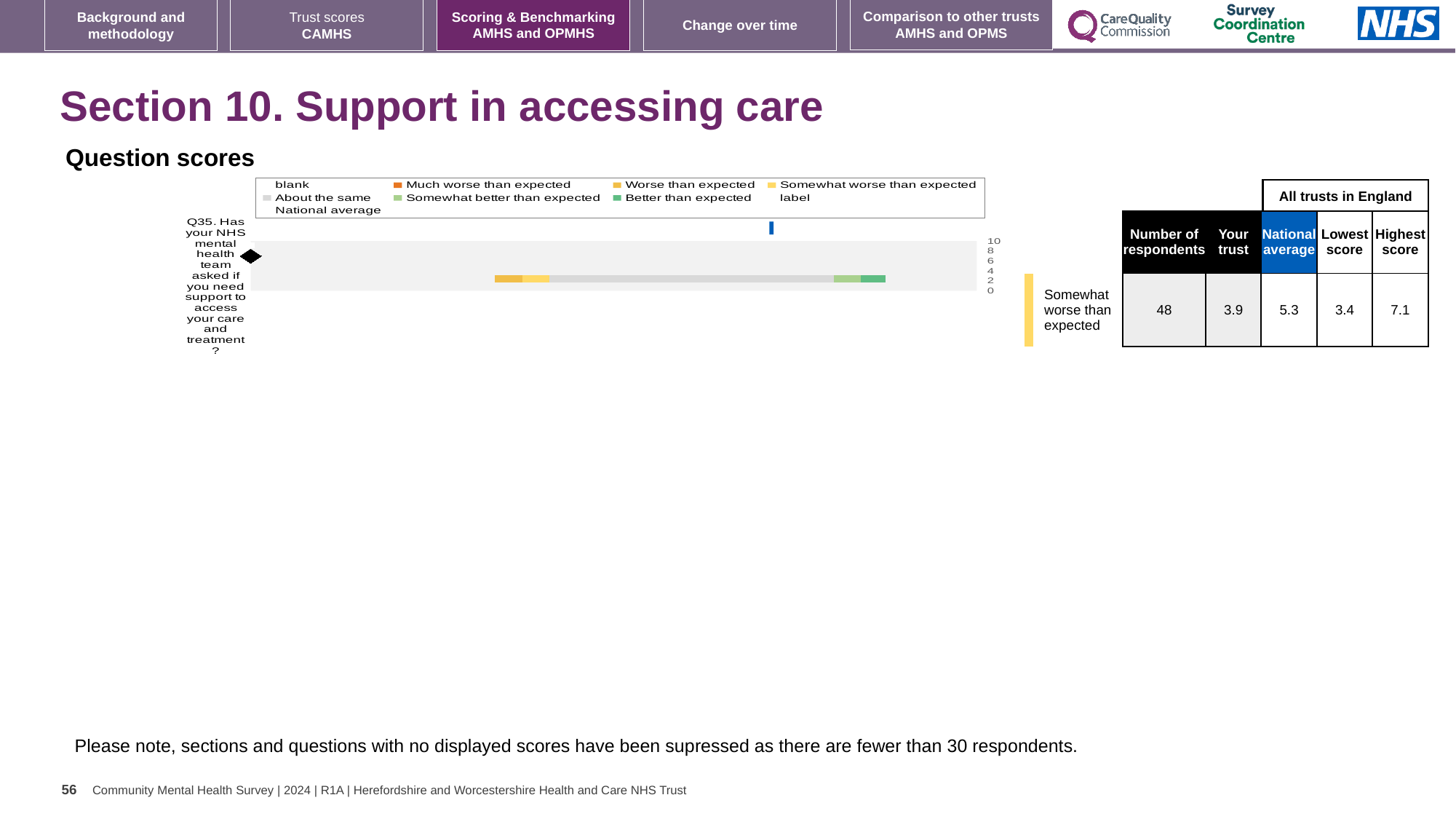
How many questions are plotted in the Question scores chart? 1 What is the national average score for Q35? 5.3 Which benchmark category is the trust's Q35 score placed in? Somewhat worse than expected What kind of chart is used to show the Q35 question score? bar chart What is the highest score among all trusts in England for Q35? 7.1 By how much is the national average higher than the trust's score for Q35? 1.4 What is the difference between the highest and lowest scores for Q35 across all trusts in England? 3.7 What is the lowest score among all trusts in England for Q35? 3.4 Which is larger for Q35: the trust's score or the national average? National average What is the 'Your trust' score for Q35 (Has your NHS mental health team asked if you need support to access your care and treatment?)? 3.9 What is the maximum value shown on the score axis of the Q35 chart? 10 How many respondents answered Q35? 48